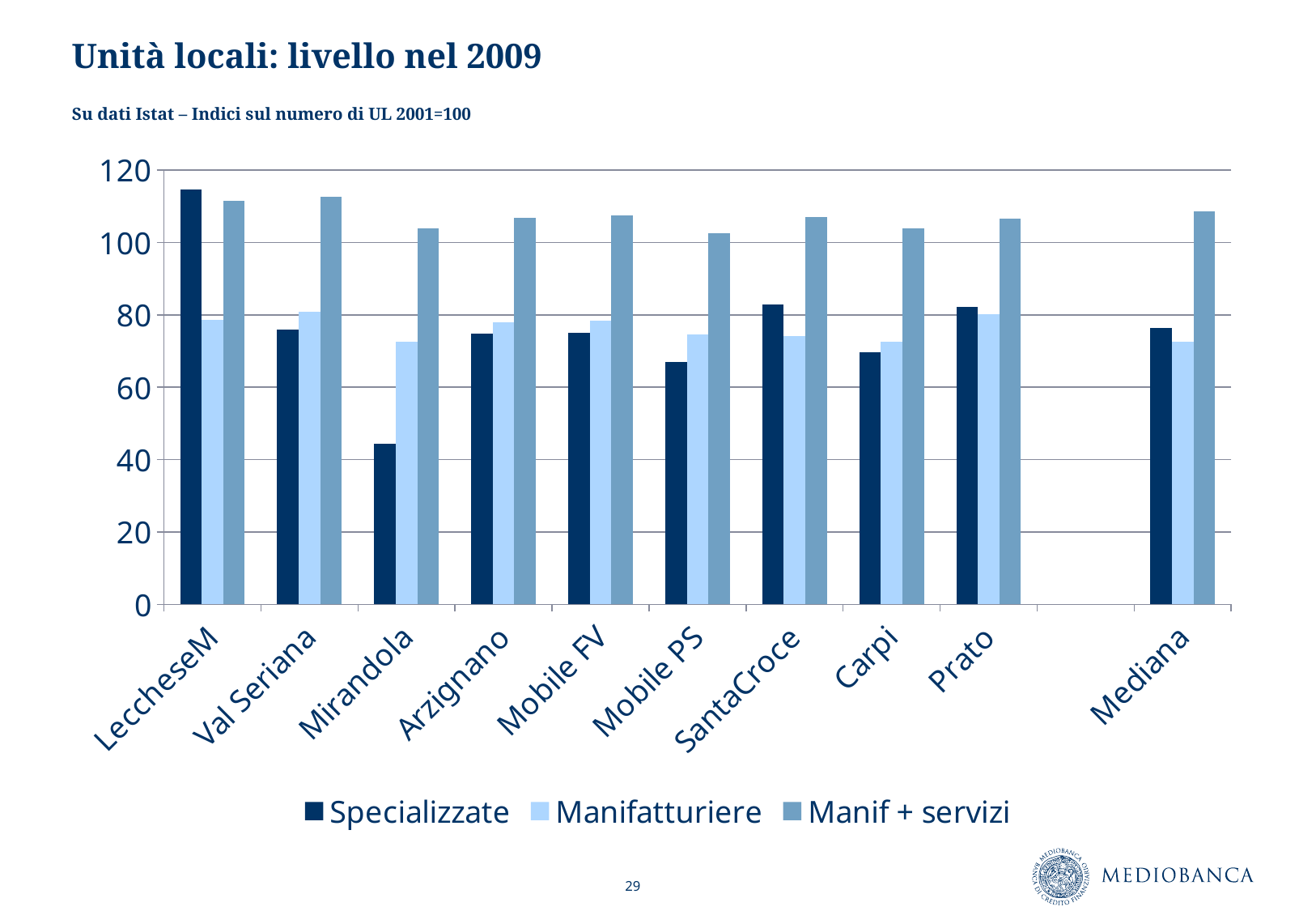
How many series does the legend list? 3 Is the Specializzate value for LeccheseM greater or less than 100? greater For Mirandola, which is larger: the Specializzate value or the Manifatturiere value? Manifatturiere Is the Specializzate value for Mobile PS greater or less than 80? less Is the Manif + servizi value for Mobile PS greater or less than 100? greater What is the title of the chart? Unità locali: livello nel 2009 What kind of chart is shown on the slide? bar chart For SantaCroce, which is larger: the Specializzate value or the Manifatturiere value? Specializzate How many categories are shown on the x axis? 10 Which category has the highest Specializzate value? LeccheseM Which category has the lowest Specializzate value? Mirandola